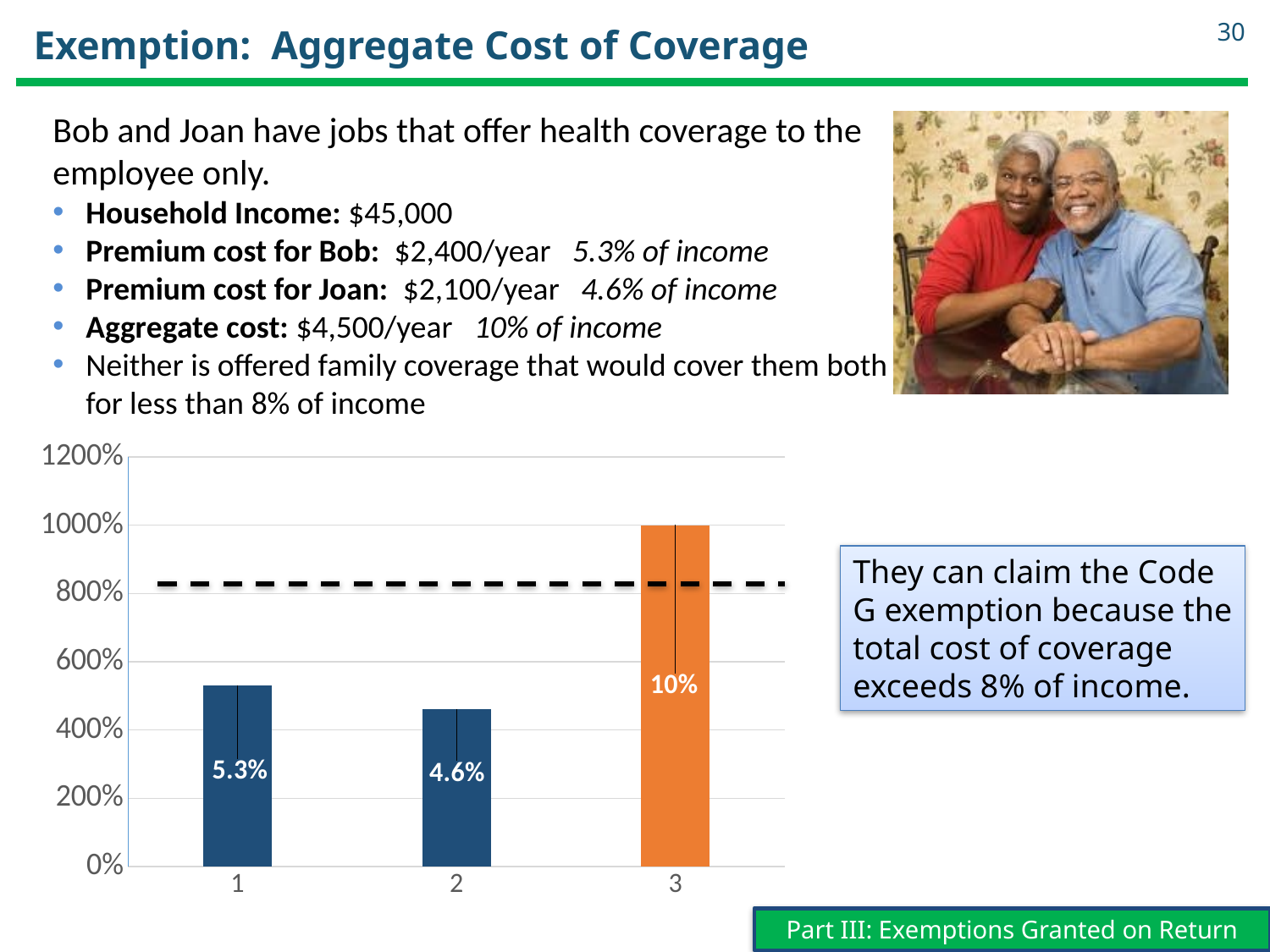
What is the difference between the labelled values for category 3 and category 1? 4.7% How many bars are plotted in the chart? 3 What is the data label on the bar for category 3? 10% Which category has the shortest bar? 2 What is the difference between the labelled values for category 1 and category 2? 0.7% What type of chart is shown on the slide? bar chart Which category has the tallest bar? 3 What is the data label on the bar for category 2? 4.6% Does the bar for category 3 reach above or below the 800% tick on the axis? above What colour is the bar for category 3? orange What is the data label on the bar for category 1? 5.3% Which bar is taller, category 1 or category 2? 1